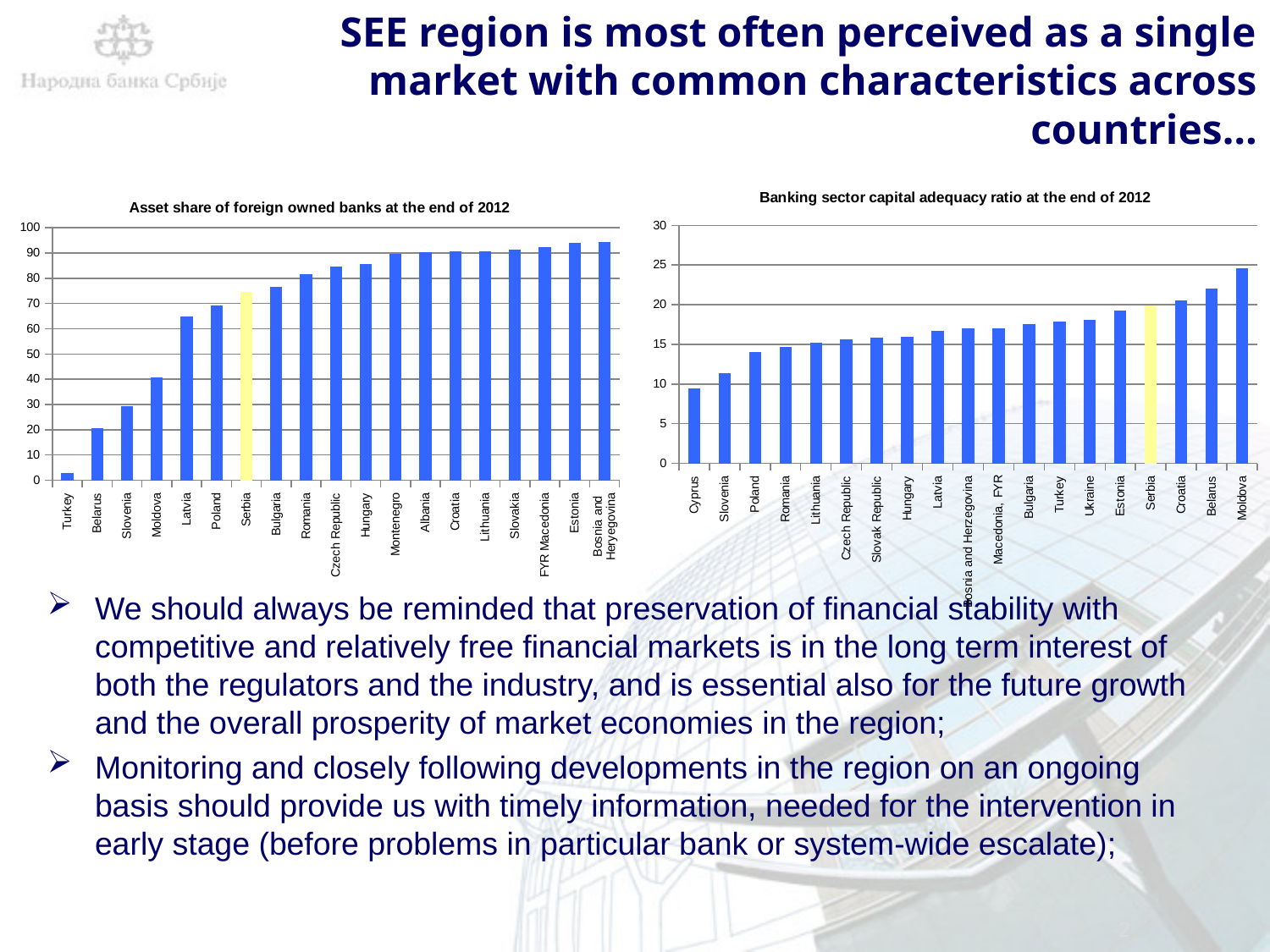
In the left chart, 'Asset share of foreign owned banks at the end of 2012', is the value for Belarus greater or less than 30? less In the left chart, 'Asset share of foreign owned banks at the end of 2012', which is larger, the value for Moldova or the value for Latvia? Latvia In the left chart, 'Asset share of foreign owned banks at the end of 2012', how many countries are shown? 19 In the left chart, 'Asset share of foreign owned banks at the end of 2012', is the value for Serbia greater or less than 70? greater In the right chart, 'Banking sector capital adequacy ratio at the end of 2012', is the value for Cyprus greater or less than 10? less What kind of chart is the left chart, 'Asset share of foreign owned banks at the end of 2012'? bar chart In the left chart, 'Asset share of foreign owned banks at the end of 2012', do the values rise or fall from left to right? rise In the right chart, 'Banking sector capital adequacy ratio at the end of 2012', which country has the highest value? Moldova In the right chart, 'Banking sector capital adequacy ratio at the end of 2012', which is larger, the value for Croatia or the value for Poland? Croatia In the right chart, 'Banking sector capital adequacy ratio at the end of 2012', which country's bar is highlighted in yellow? Serbia In the right chart, 'Banking sector capital adequacy ratio at the end of 2012', which country has the lowest value? Cyprus In the left chart, 'Asset share of foreign owned banks at the end of 2012', which country has the lowest value? Turkey